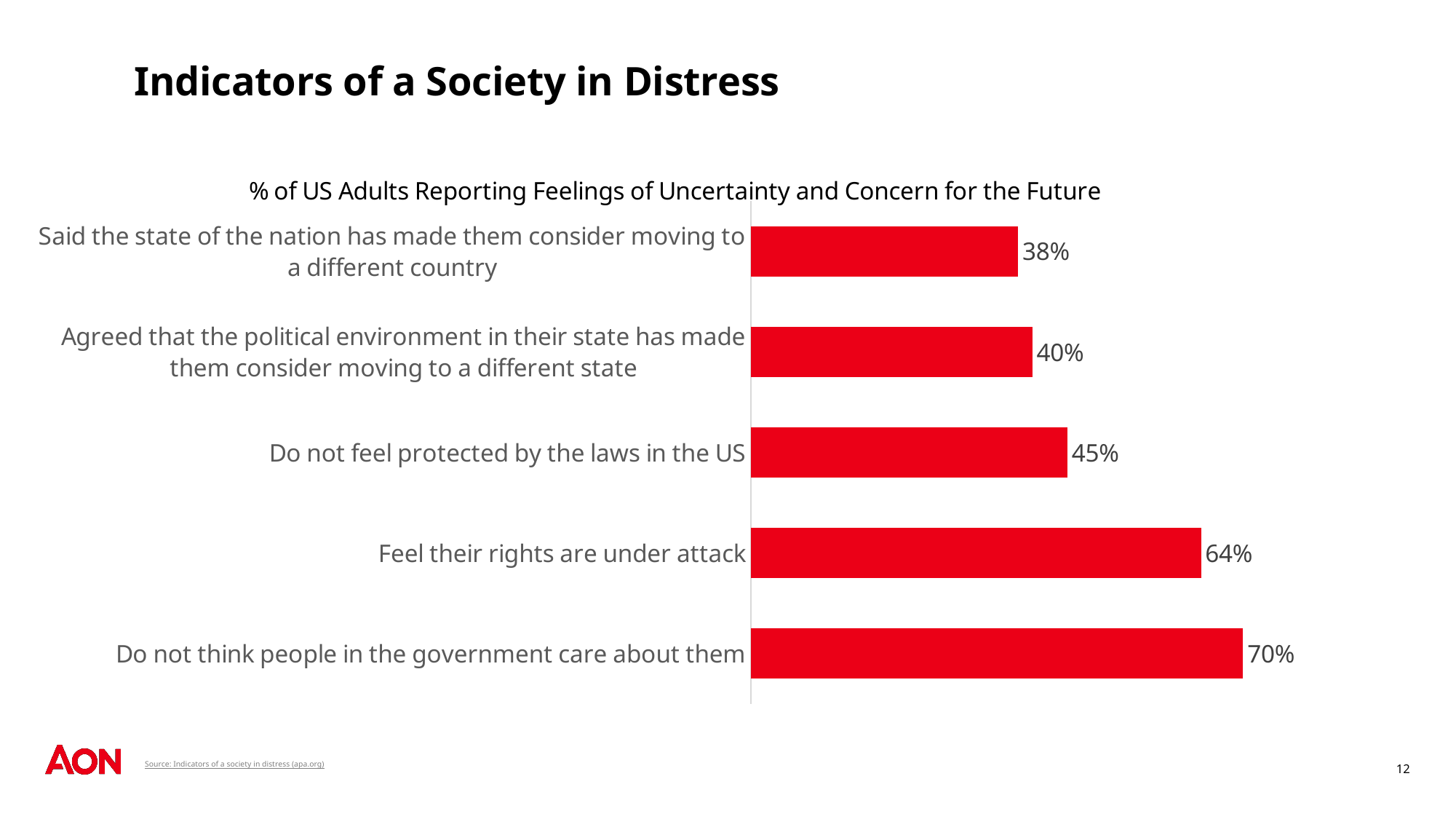
What is the title of the chart? % of US Adults Reporting Feelings of Uncertainty and Concern for the Future How many categories are shown in the chart? 5 What percentage of US adults feel their rights are under attack? 64% What percentage of US adults do not think people in the government care about them? 70% What percentage of US adults do not feel protected by the laws in the US? 45% What is the difference between the percentage who do not feel protected by the laws in the US and the percentage who agreed the political environment in their state made them consider moving to a different state? 5% Which category has the lowest percentage? Said the state of the nation has made them consider moving to a different country What type of chart is shown on the slide? Bar chart What percentage said the state of the nation has made them consider moving to a different country? 38% What is the difference between the percentage who do not think people in the government care about them and the percentage who feel their rights are under attack? 6% Which category has the highest percentage? Do not think people in the government care about them Which is larger: the percentage who feel their rights are under attack or the percentage who do not feel protected by the laws in the US? Feel their rights are under attack